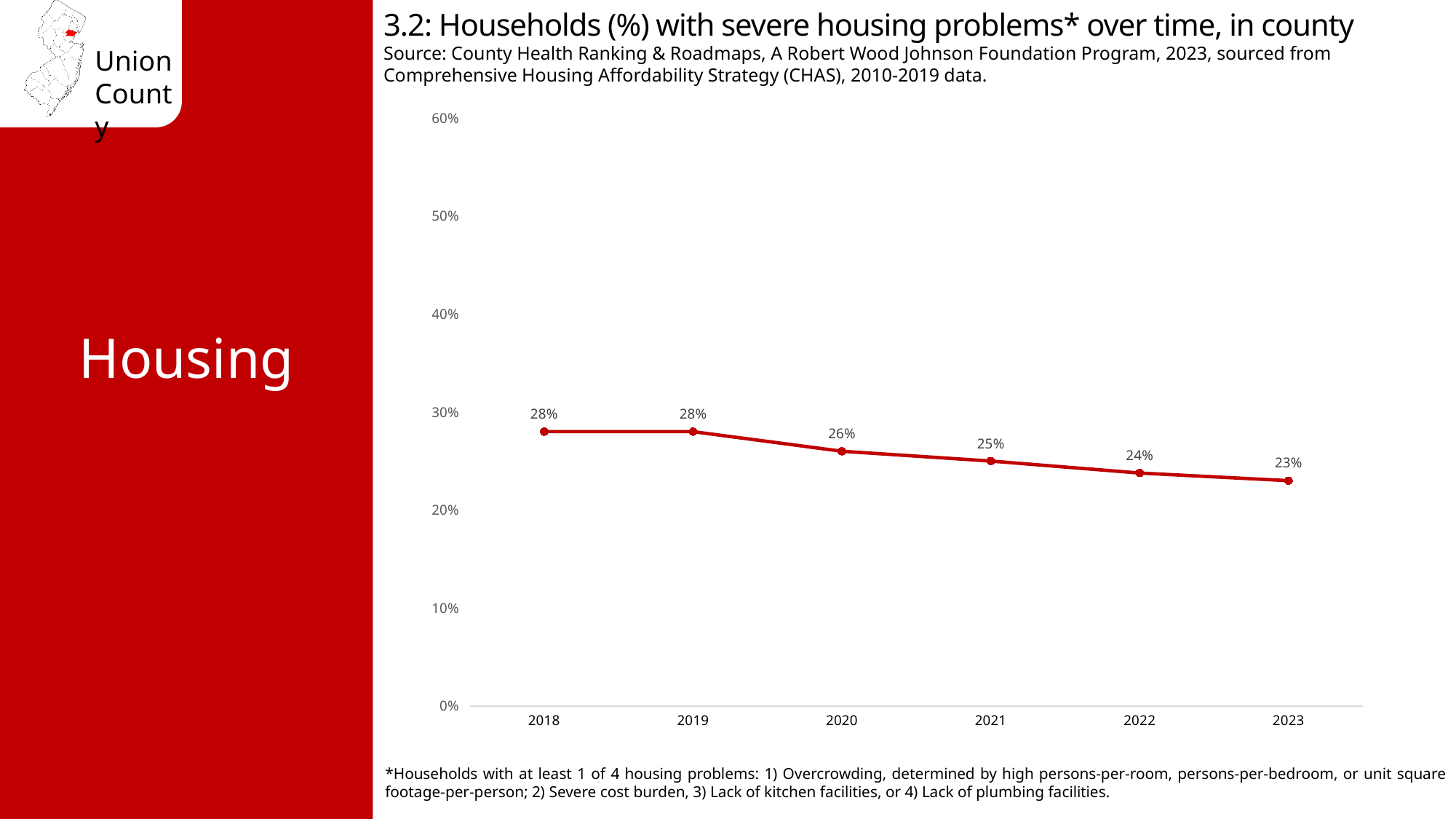
Which is larger, the value for 2020 or the value for 2022? 2020 Do the values rise or fall from 2018 to 2023? fall What is the value shown for 2020? 26% How many years are plotted on the chart? 6 What is the title of the chart? 3.2: Households (%) with severe housing problems* over time, in county What percentage of households had severe housing problems in 2018? 28% What is the difference between the 2018 value and the 2023 value? 5% What kind of chart is shown on the slide? line chart What is the value shown for 2021? 25% Is the value for 2019 greater or less than 30%? less What percentage of households had severe housing problems in 2023? 23% Which year has the lowest percentage of households with severe housing problems? 2023